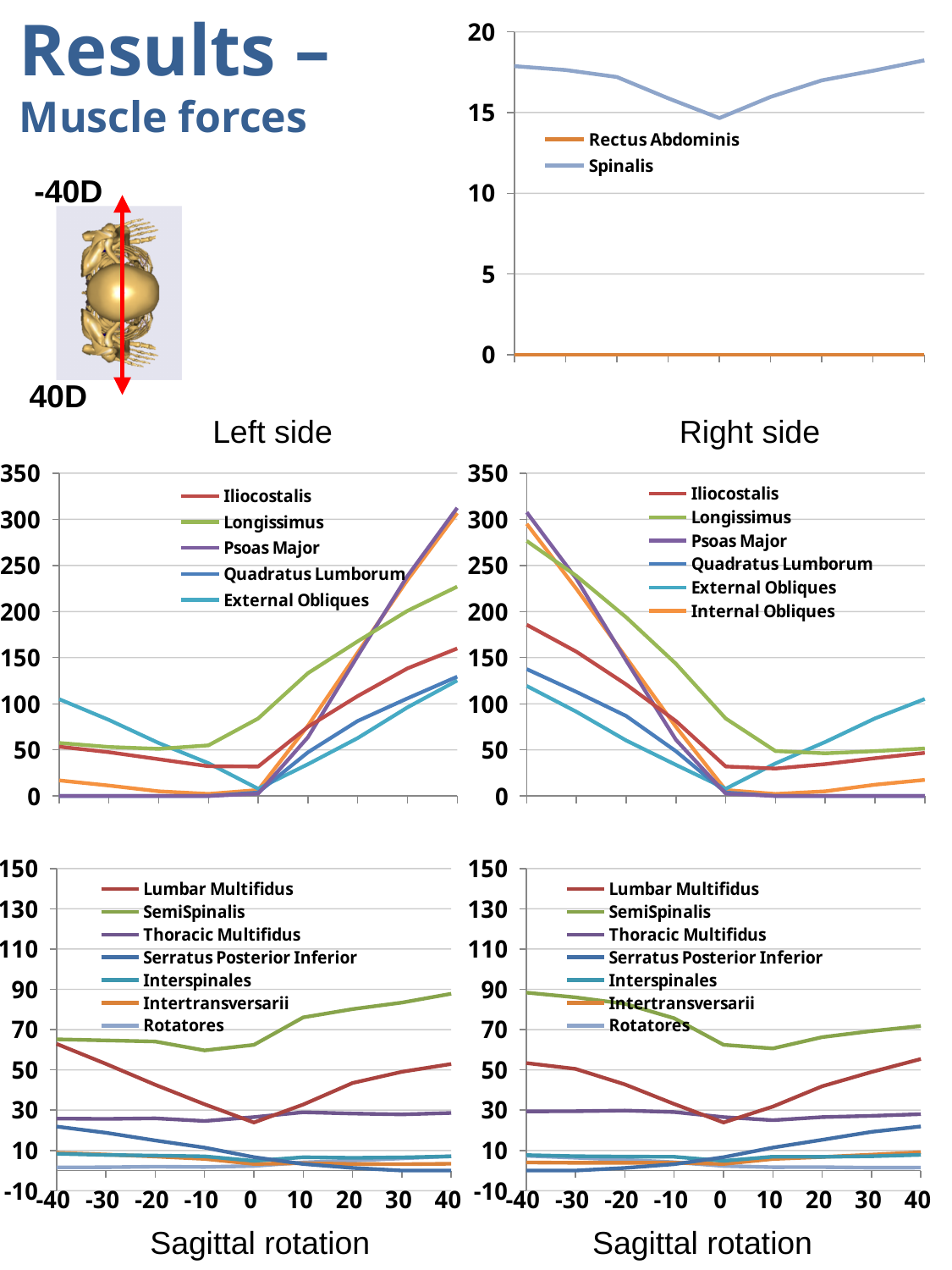
In the bottom-right chart, which series has the highest value at -40? SemiSpinalis In the bottom-left chart, does the Lumbar Multifidus line rise or fall from -40 to 0? Fall In the 'Right side' middle chart, which is larger at -40: Longissimus or Iliocostalis? Longissimus How many series does the legend of the bottom-left chart list? 7 How many series does the legend of the top-right chart list? 2 How many series does the legend of the 'Right side' middle chart list? 6 What is the x-axis title of the bottom charts? Sagittal rotation In the 'Left side' middle chart, which is larger at 40: Psoas Major or Longissimus? Psoas Major In the top-right chart, is the value for Spinalis at -40 greater or less than 15? greater In the 'Left side' middle chart, is the value for Psoas Major at 40 greater or less than 250? greater What kind of chart is the 'Left side' chart in the middle of the slide? Line chart In the top-right chart, is the value for Rectus Abdominis at 0 greater or less than 5? less